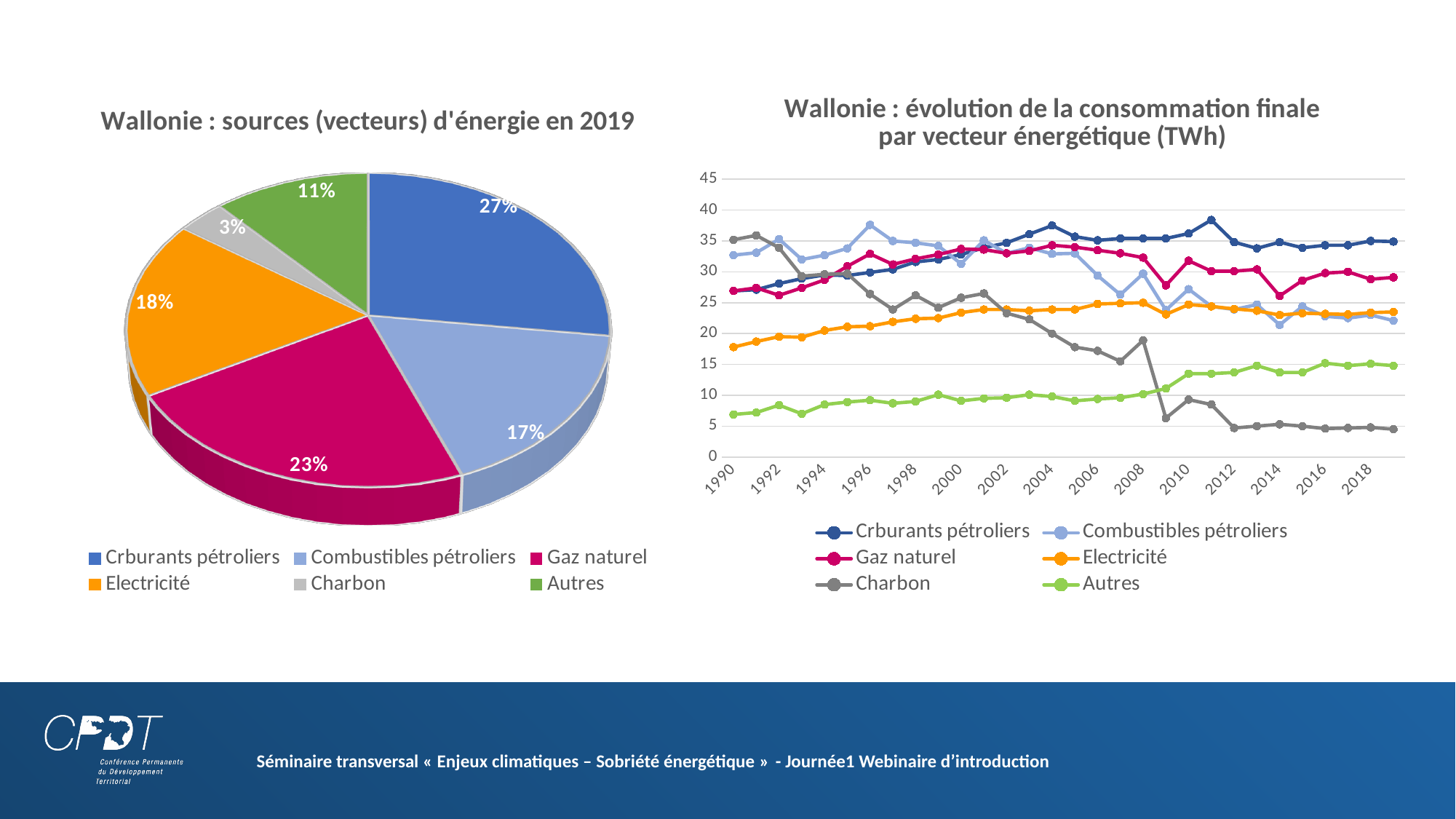
In the pie chart on the left, which energy source has the smallest share? Charbon How many slices does the pie chart on the left have? 6 What kind of chart is the chart on the left of the slide? Pie chart In the pie chart on the left, what is the difference in percentage points between Crburants pétroliers and Combustibles pétroliers? 10 percentage points How many series does the legend of the chart 'Wallonie : évolution de la consommation finale par vecteur énergétique (TWh)' list? 6 In the line chart on the right, is the value for Autres in 2018 greater or less than 10? greater In the line chart on the right, which series has the higher value in 2018: Crburants pétroliers or Charbon? Crburants pétroliers What kind of chart is the chart on the right of the slide? Line chart In the pie chart 'Wallonie : sources (vecteurs) d'énergie en 2019', what share does Electricité have? 18% In the pie chart 'Wallonie : sources (vecteurs) d'énergie en 2019', what share does Gaz naturel have? 23% In the pie chart on the left, which energy source has the largest share? Crburants pétroliers In the line chart on the right, does the Charbon series rise or fall overall from 1990 to 2019? Fall